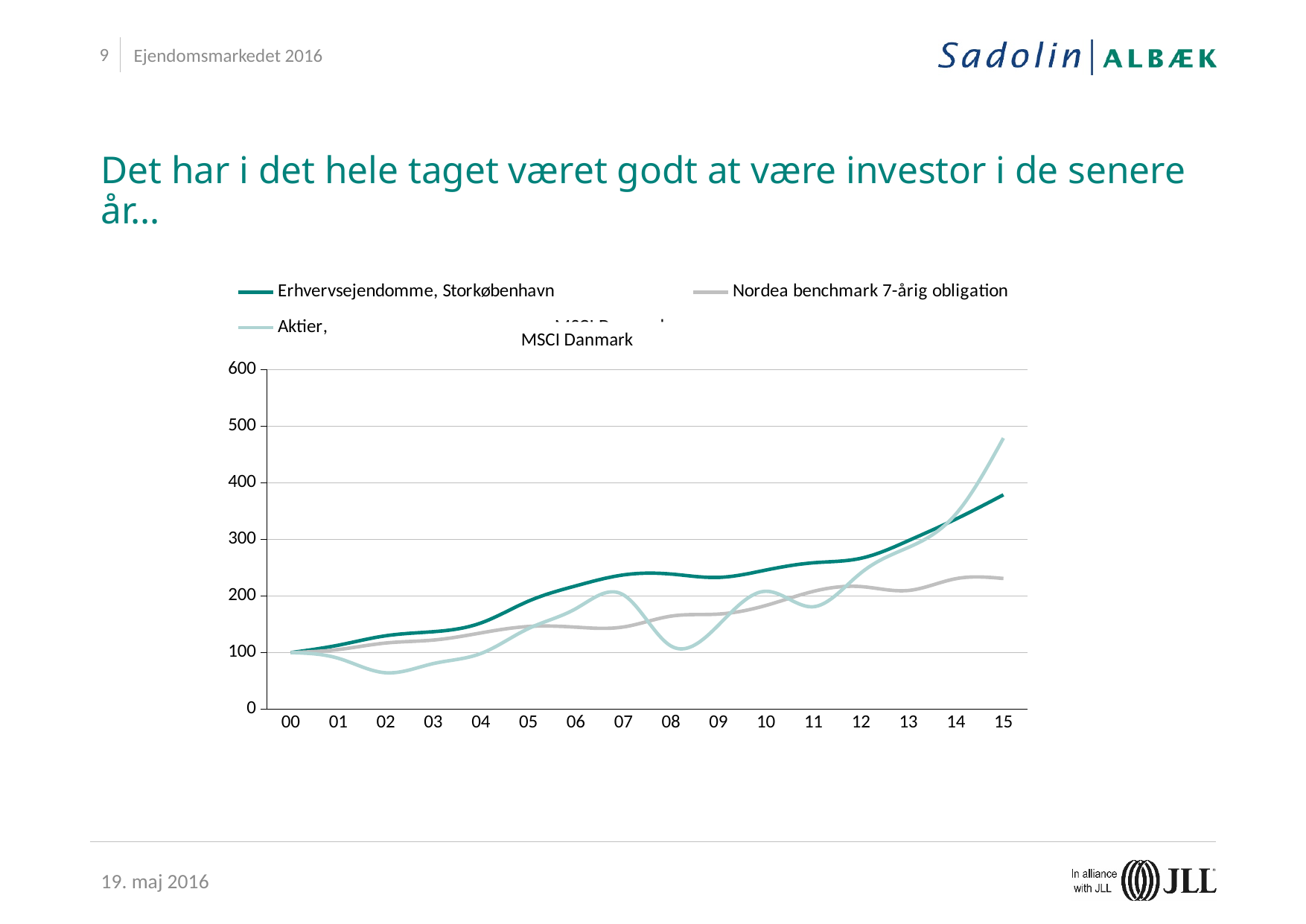
Is the value for Aktier, MSCI Danmark in 02 greater or less than 100? less Is the value for Aktier, MSCI Danmark in 15 greater or less than 400? greater Which series has the highest value in 15? Aktier, MSCI Danmark What is the value of all three series in 00? 100 Is the value for Nordea benchmark 7-årig obligation in 15 greater or less than 300? less How many years are shown on the x axis? 16 What kind of chart is shown on the slide? line chart Which series has the lowest value in 15? Nordea benchmark 7-årig obligation Does the Erhvervsejendomme, Storkøbenhavn series rise or fall overall from 00 to 15? rise How many series does the legend list? 3 In 07, which is higher: Erhvervsejendomme, Storkøbenhavn or Nordea benchmark 7-årig obligation? Erhvervsejendomme, Storkøbenhavn